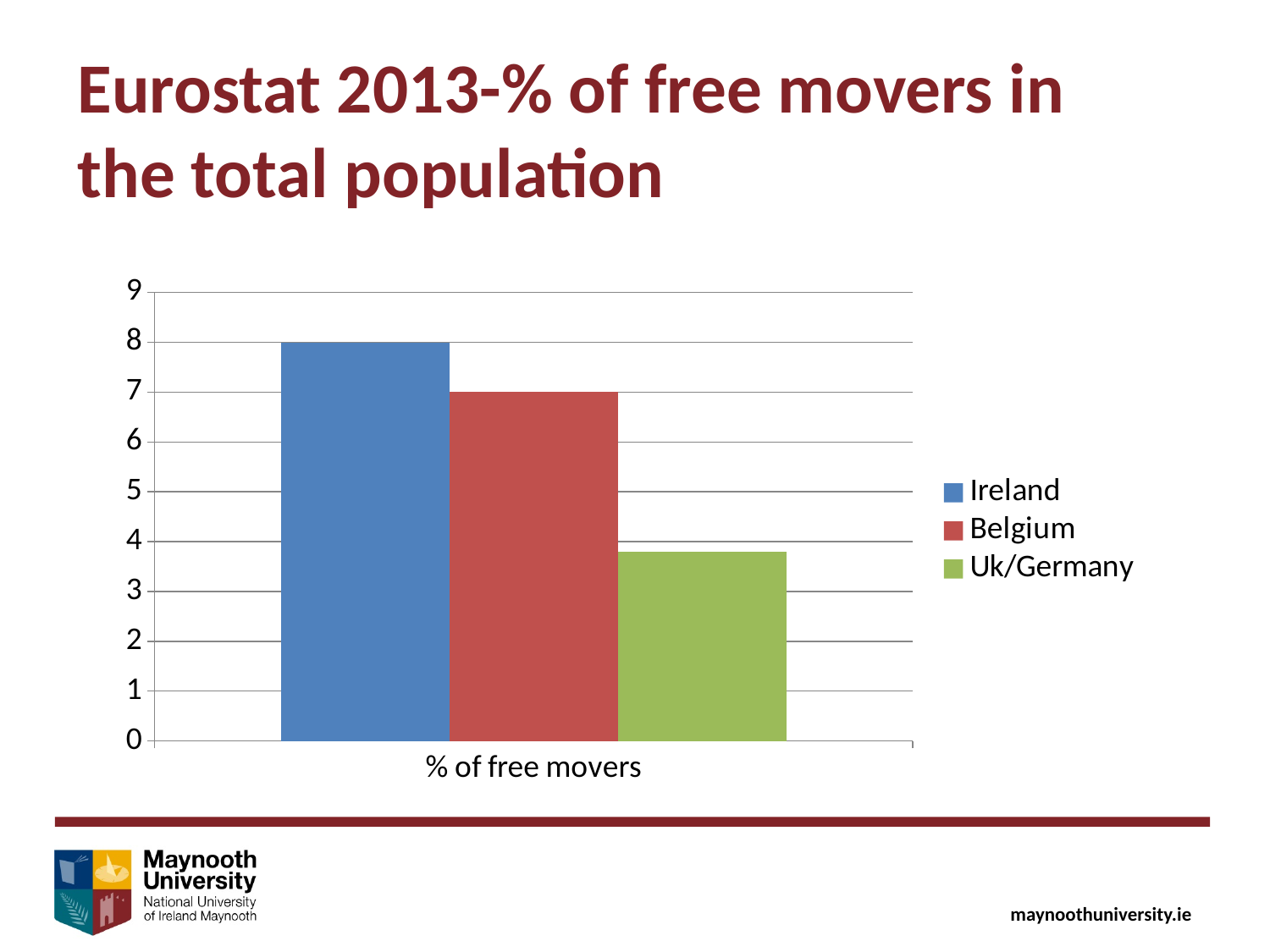
Which series has the lowest value? Uk/Germany What kind of chart is shown on the slide? bar chart Which is larger, the value for Belgium or the value for Uk/Germany? Belgium How many series does the legend list? 3 What is the difference between the values for Ireland and Belgium? 1 Is the value for Uk/Germany greater or less than 4? less How many bars are plotted in the chart? 3 What is the value for Belgium? 7 Is the value for Uk/Germany greater or less than 3? greater What is the value for Ireland? 8 Which series has the highest value? Ireland What is the category label shown on the x axis? % of free movers